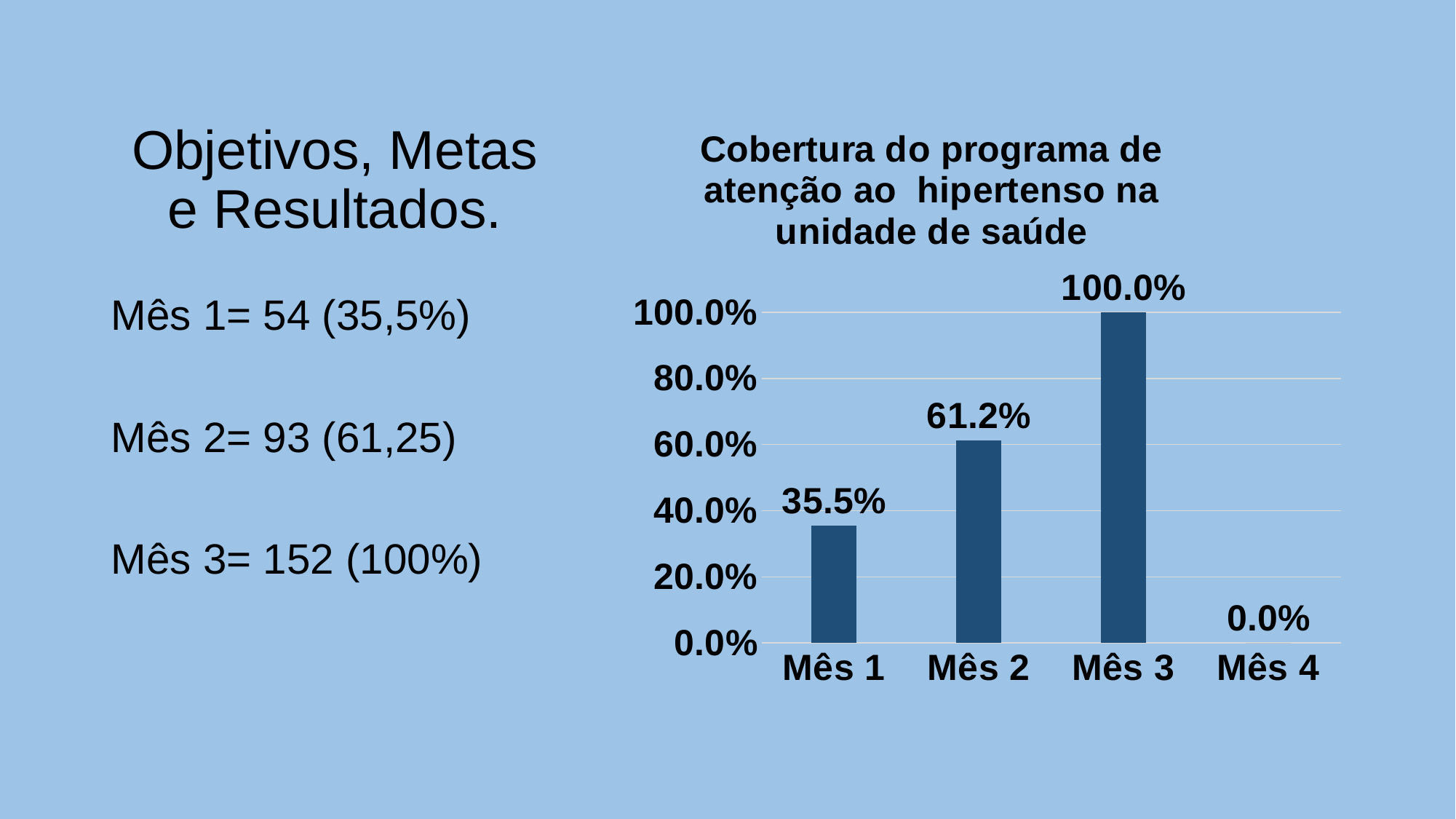
What kind of chart is shown? bar chart What is the value for Mês 4? 0.0% What is the value for Mês 1? 35.5% Which is larger, the value for Mês 1 or the value for Mês 2? Mês 2 Which category has the lowest value? Mês 4 How many categories are shown on the x axis? 4 What is the value for Mês 3? 100.0% What is the difference between the values for Mês 3 and Mês 2? 38.8% What is the value for Mês 2? 61.2% What is the title of the chart? Cobertura do programa de atenção ao hipertenso na unidade de saúde Which category has the highest value? Mês 3 What is the difference between the values for Mês 2 and Mês 1? 25.7%